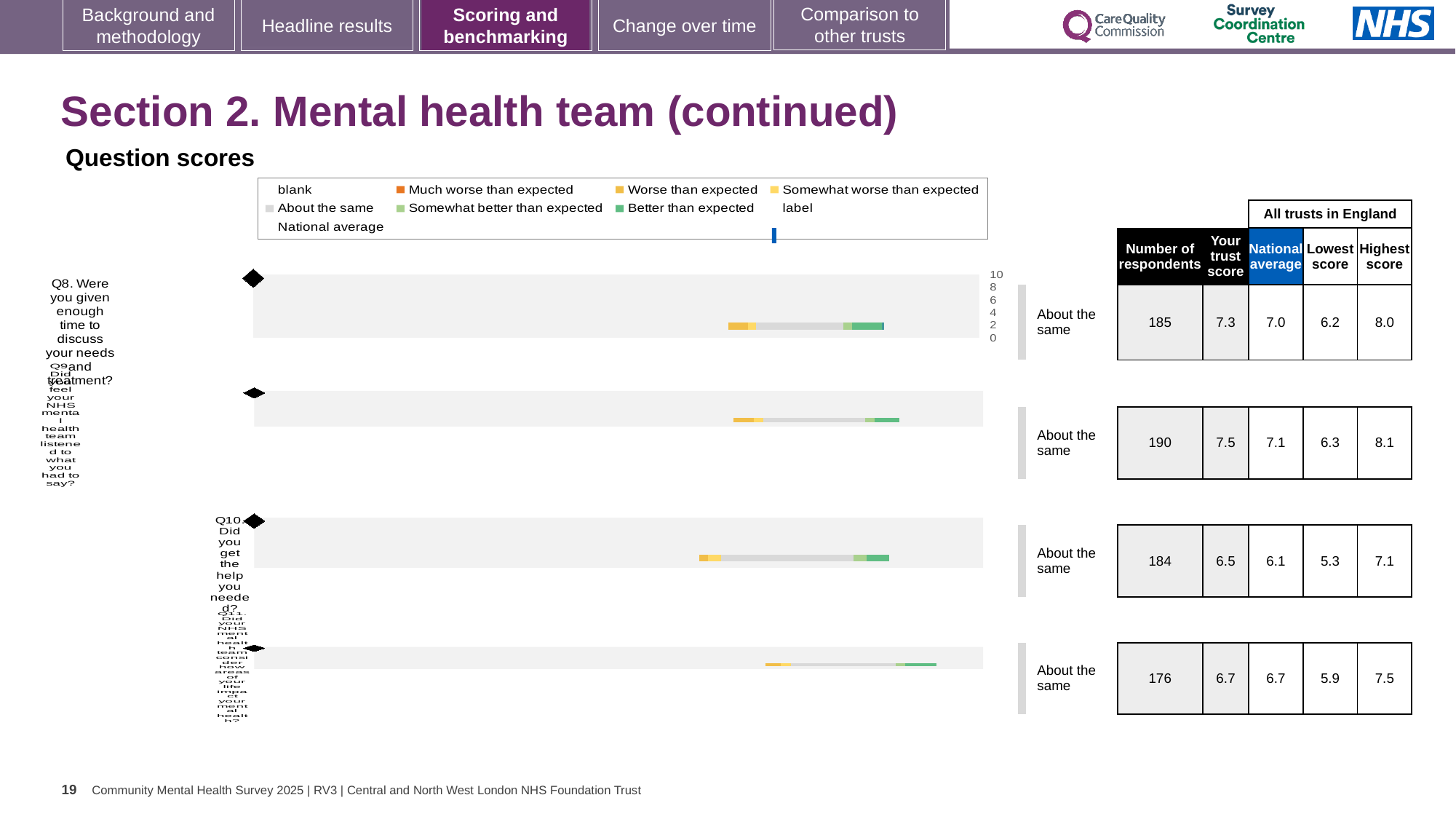
What kind of chart is used to show the question scores on this slide? bar chart What benchmark category is shown next to the Q8 chart? About the same For the Q8 chart (Were you given enough time to discuss your needs and treatment?), what is the trust score shown in the table? 7.3 For the Q10 chart (Did you get the help you needed?), what is the national average score? 6.1 How many question charts (Q8 to Q11) are shown on the slide? 4 For the Q11 chart, how many respondents are shown? 176 For the Q9 chart, which is larger: the trust score or the national average? trust score For the Q10 chart, what is the highest score among all trusts in England? 7.1 What is the maximum value shown on the score axis of the charts? 10 Which question chart has the lowest trust score? Q10 For the Q8 chart, what is the difference between the trust score and the national average? 0.3 Which question chart has the highest trust score? Q9